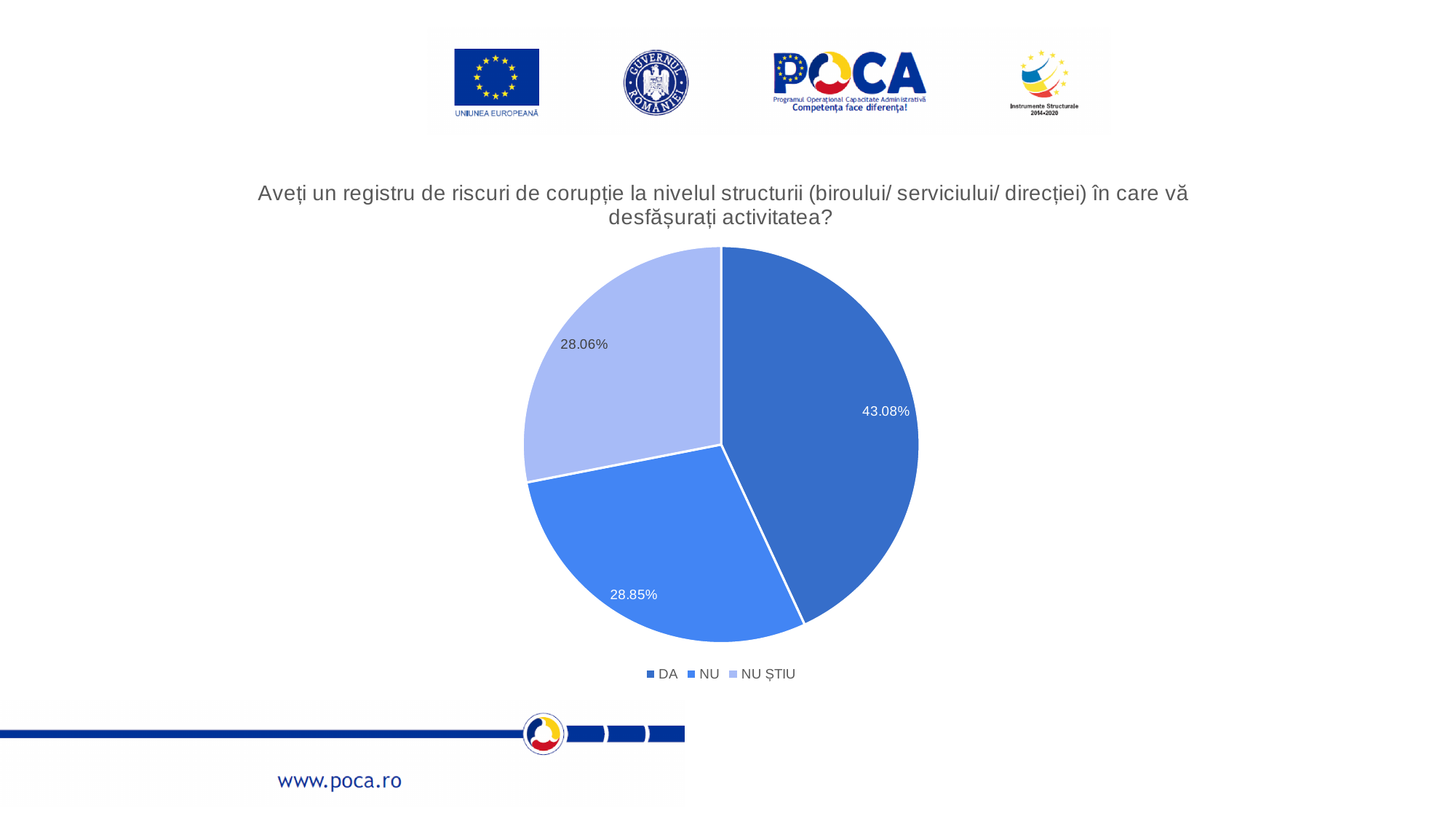
What is the difference in percentage points between the NU and NU ȘTIU slices? 0.79 What share of the pie does the NU slice represent? 28.85% How many entries does the legend list? 3 Which response has the largest share of the pie? DA How many slices does the pie chart have? 3 Which is larger, the DA slice or the NU ȘTIU slice? DA Which response has the smallest share of the pie? NU ȘTIU What kind of chart is shown on the slide? Pie chart What share of the pie does the NU ȘTIU slice represent? 28.06% Which legend entry is shown in the lightest blue colour? NU ȘTIU What is the difference in percentage points between the DA and NU slices? 14.23 What share of the pie does the DA slice represent? 43.08%